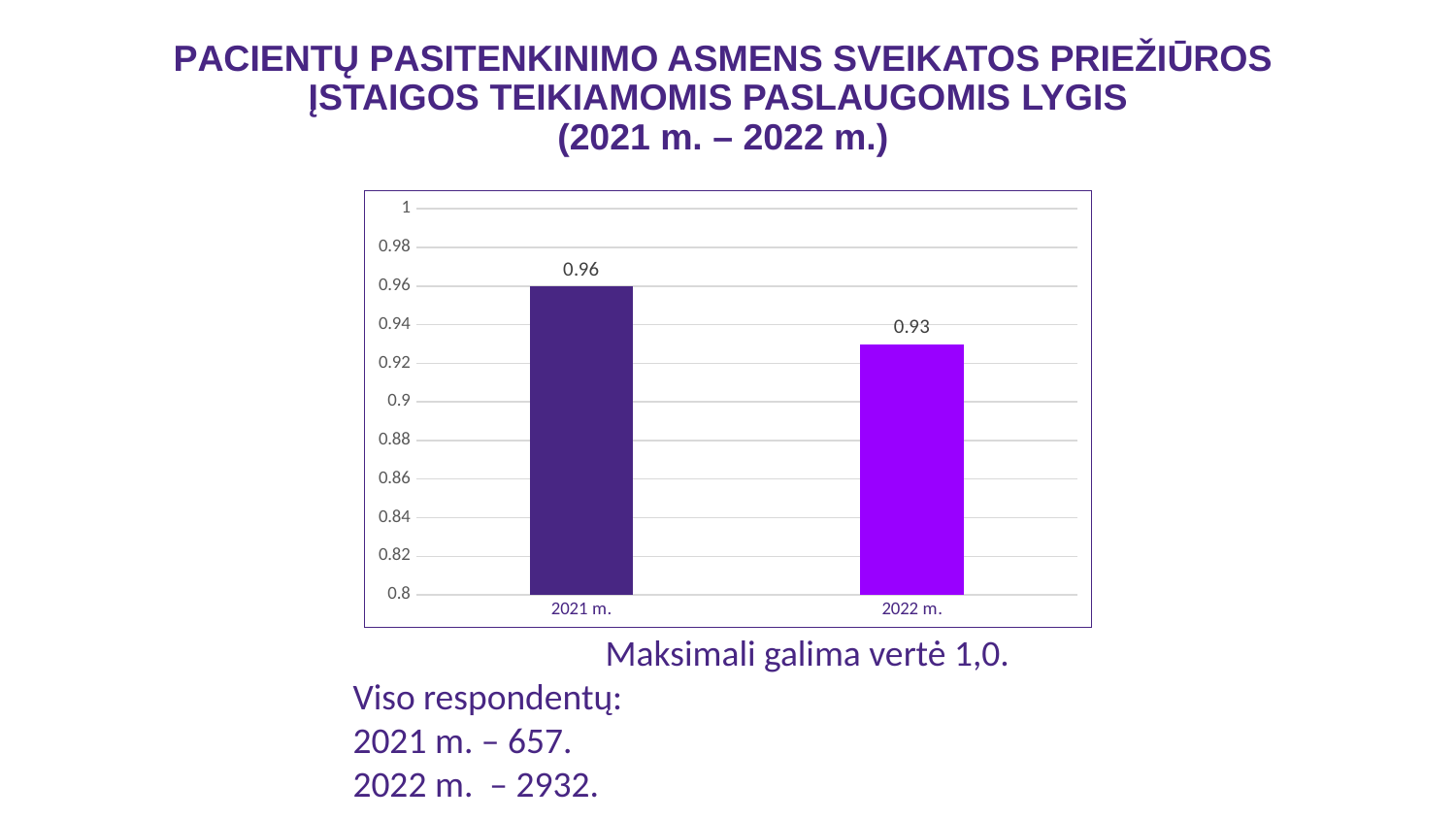
What is the value for 2021 m.? 0.96 What is the difference between the values for 2021 m. and 2022 m.? 0.03 Do the values rise or fall from 2021 m. to 2022 m.? fall What is the lowest value shown on the y axis? 0.8 Is the value for 2021 m. greater or less than 0.98? less Is the value for 2022 m. larger or smaller than the value for 2021 m.? smaller How many categories are shown on the x axis? 2 What kind of chart is shown on the slide? bar chart Which year has the lower value? 2022 m. Is the value for 2022 m. greater or less than 0.9? greater What is the value for 2022 m.? 0.93 Which year has the higher value? 2021 m.